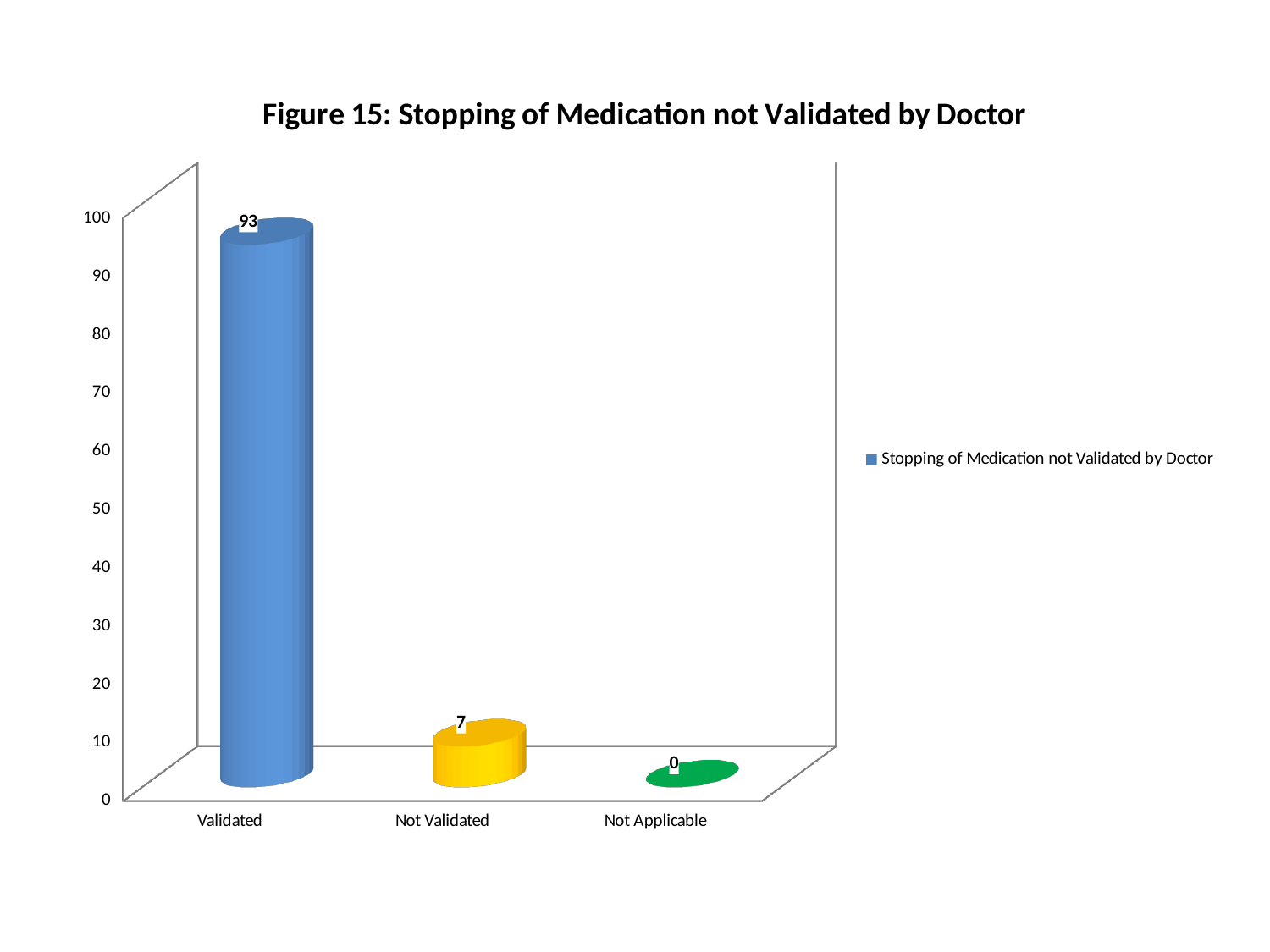
How many categories are shown on the x axis? 3 What is the title of the chart? Figure 15: Stopping of Medication not Validated by Doctor What is the value for Not Applicable? 0 What kind of chart is shown on the slide? bar chart Is the value for Validated greater or less than 50? greater Which category has the highest value? Validated Which is larger, the value for Not Validated or the value for Not Applicable? Not Validated Which category has the lowest value? Not Applicable What is the value for Validated? 93 What is the difference between the values for Validated and Not Validated? 86 What is the value for Not Validated? 7 How many series does the legend list? 1